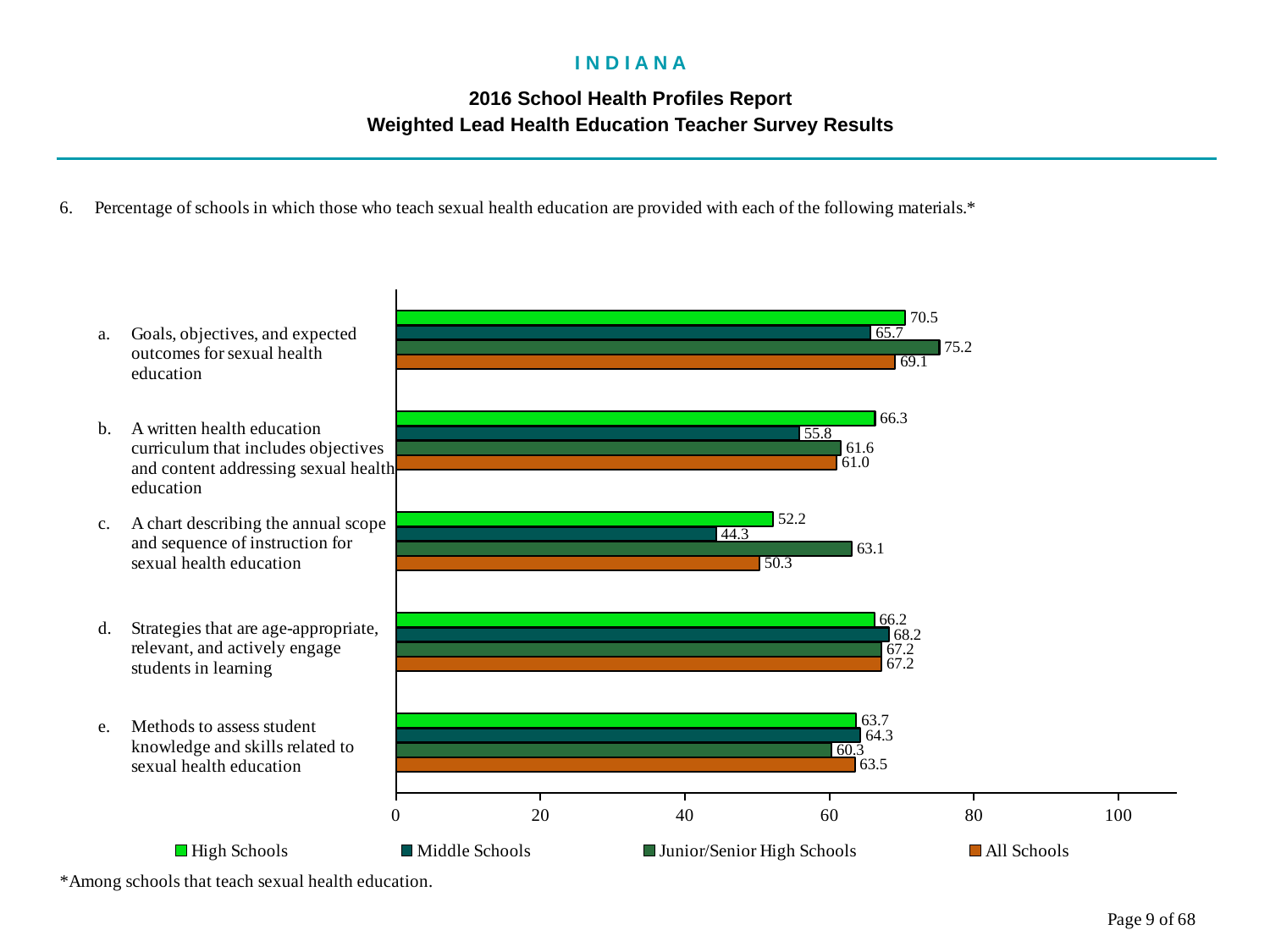
How many series does the legend list? 4 Which category has the highest High Schools value? a. Goals, objectives, and expected outcomes for sexual health education What is the difference between the High Schools and Middle Schools values for category b (a written health education curriculum)? 10.5 What is the value for Middle Schools for category c (a chart describing the annual scope and sequence of instruction for sexual health education)? 44.3 For category d (strategies that are age-appropriate, relevant, and actively engage students in learning), which is larger: the Middle Schools value or the High Schools value? Middle Schools How many categories (materials) are shown in the chart? 5 What is the All Schools value for category e (methods to assess student knowledge and skills related to sexual health education)? 63.5 Is the Middle Schools value for category c greater or less than 60? less What is the value for Junior/Senior High Schools for category a (goals, objectives, and expected outcomes for sexual health education)? 75.2 Which category has the lowest All Schools value? c. A chart describing the annual scope and sequence of instruction for sexual health education Which series is shown in orange in the legend? All Schools What kind of chart is shown on the slide? bar chart